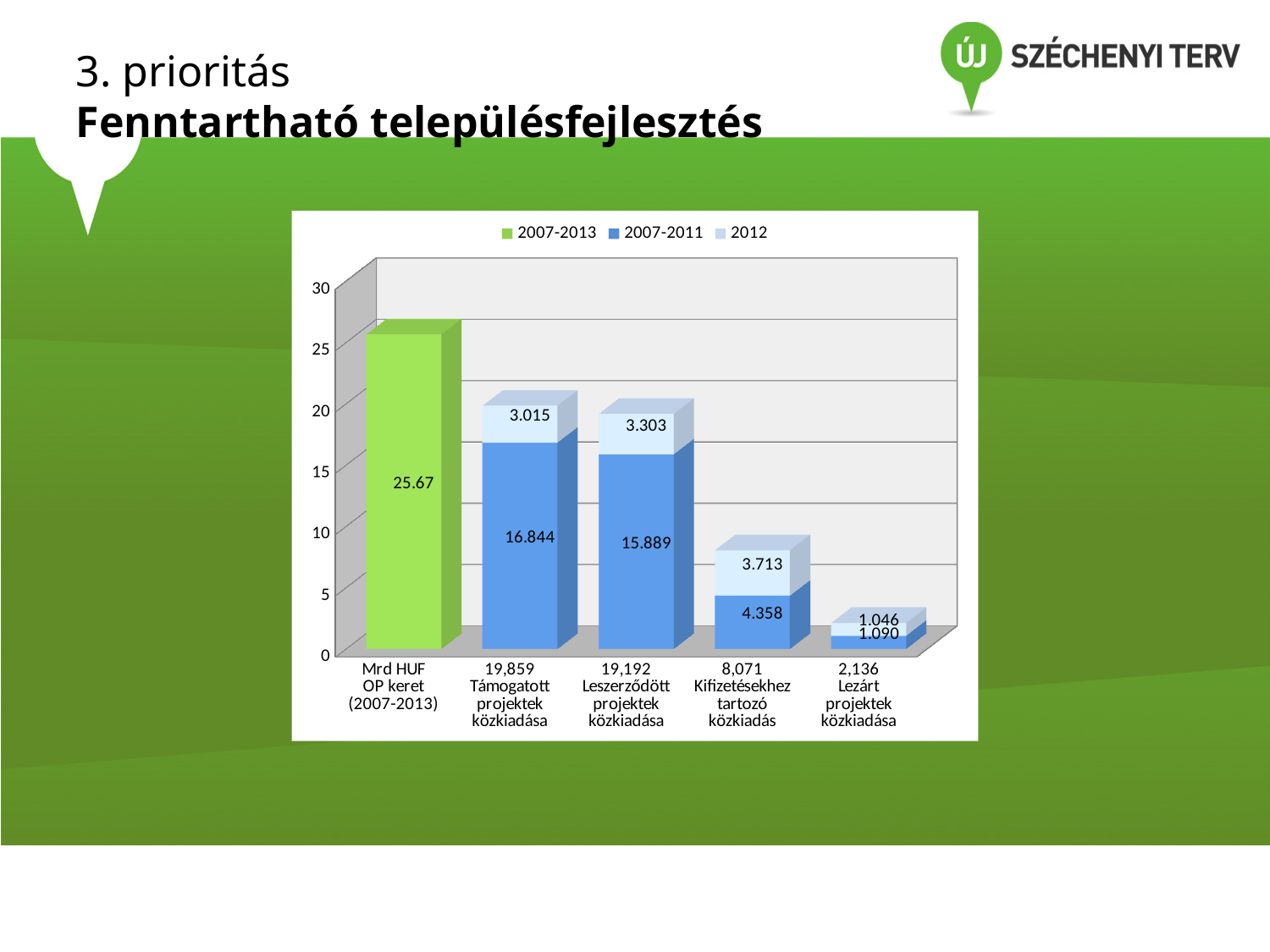
What is the total of the stacked bar for 'Lezárt projektek közkiadása'? 2.136 How many categories are shown on the x axis? 5 What is the 2007-2011 value for 'Támogatott projektek közkiadása'? 16.844 Which is larger: the 2012 value for 'Támogatott projektek közkiadása' or the 2012 value for 'Kifizetésekhez tartozó közkiadás'? Kifizetésekhez tartozó közkiadás What is the value of the 2007-2013 series for 'Mrd HUF OP keret (2007-2013)'? 25.67 How many series does the legend list? 3 Which category has the lowest 2007-2011 value? Lezárt projektek közkiadása What is the total of the stacked bar for 'Kifizetésekhez tartozó közkiadás'? 8.071 What is the 2012 value for 'Kifizetésekhez tartozó közkiadás'? 3.713 What is the 2012 value for 'Leszerződött projektek közkiadása'? 3.303 What is the difference between the 2007-2011 values for 'Támogatott projektek közkiadása' and 'Leszerződött projektek közkiadása'? 0.955 What type of chart is shown on the slide? bar chart